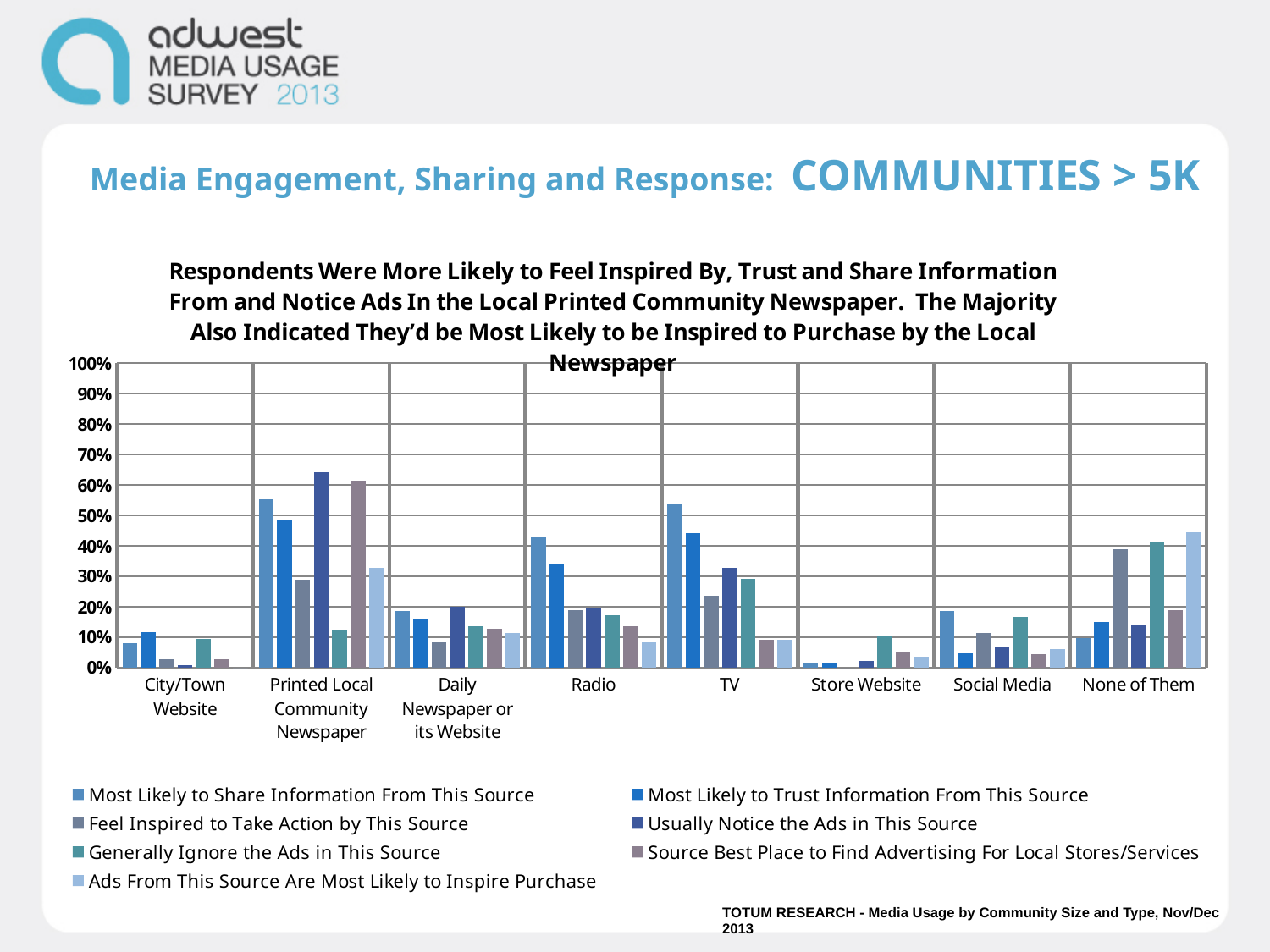
Is the value for 'Most Likely to Share Information From This Source' for TV greater or less than 50%? greater What is the highest percentage shown on the y axis? 100% Which category has the lowest value for 'Most Likely to Trust Information From This Source'? Store Website How many media source categories are shown along the x axis? 8 Which category has the highest value for 'Generally Ignore the Ads in This Source'? None of Them Is the value for 'Usually Notice the Ads in This Source' for Printed Local Community Newspaper greater or less than 60%? greater For 'Source Best Place to Find Advertising For Local Stores/Services', which is larger: Printed Local Community Newspaper or TV? Printed Local Community Newspaper Is the value for 'Most Likely to Share Information From This Source' for Radio greater or less than 50%? less Which category has the highest value for 'Usually Notice the Ads in This Source'? Printed Local Community Newspaper What kind of chart is shown on the slide? bar chart How many series does the legend list? 7